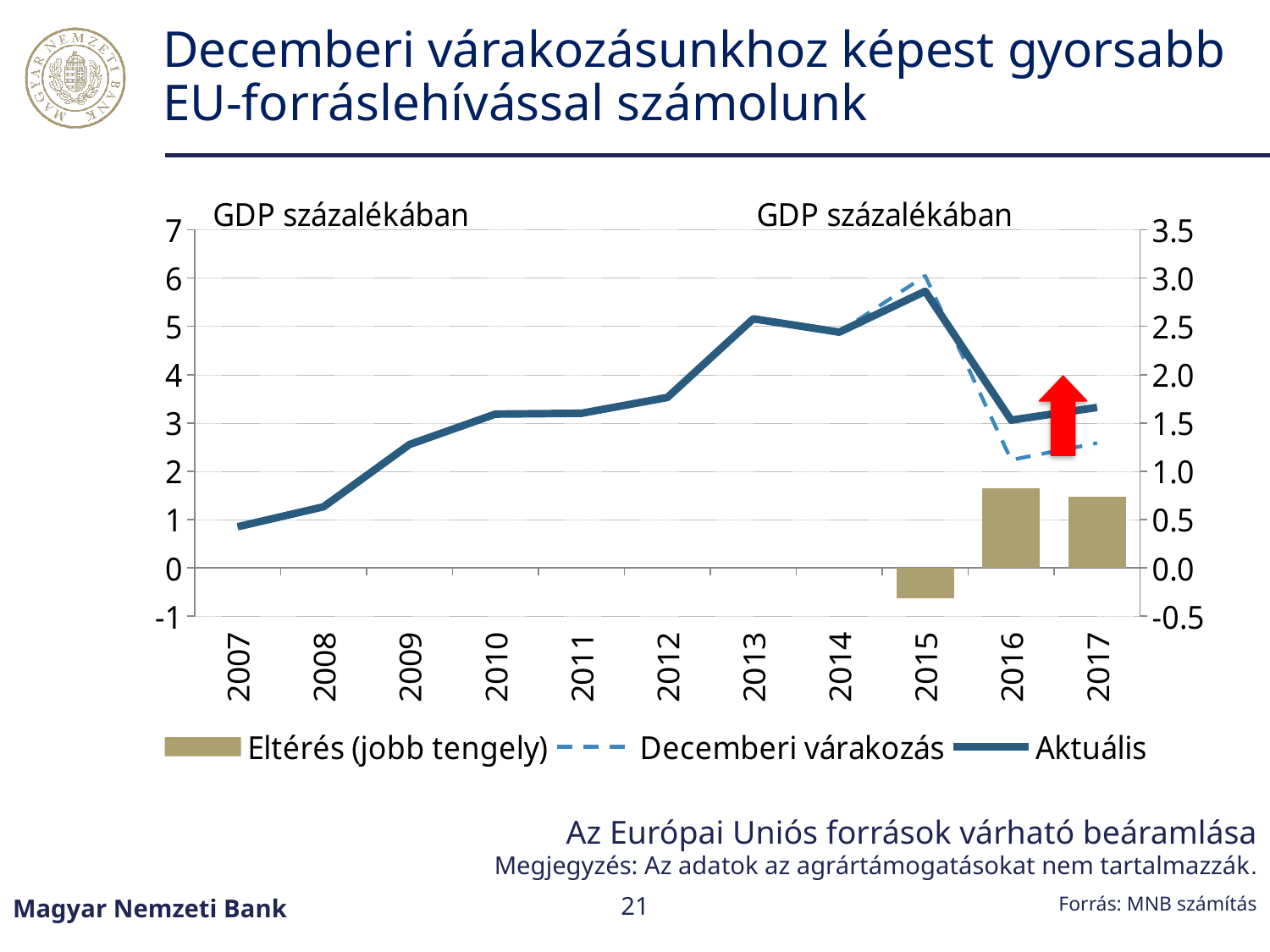
In 2016, which is larger: the Aktuális value or the Decemberi várakozás value? Aktuális Is the Eltérés (jobb tengely) bar for 2015 greater or less than 0.0 on the right axis? less Is the Aktuális value for 2015 greater or less than 5? greater Is the Aktuális value for 2016 greater or less than 2? greater How many series does the legend list? 3 What kind of chart is this? Combined line and bar chart In which year does the Aktuális series reach its highest value? 2015 How many years are shown on the x axis? 11 In which year is the Aktuális series at its lowest value? 2007 Does the Aktuális series rise or fall from 2007 to 2013? rise What is the title of the chart shown below the legend? Az Európai Uniós források várható beáramlása